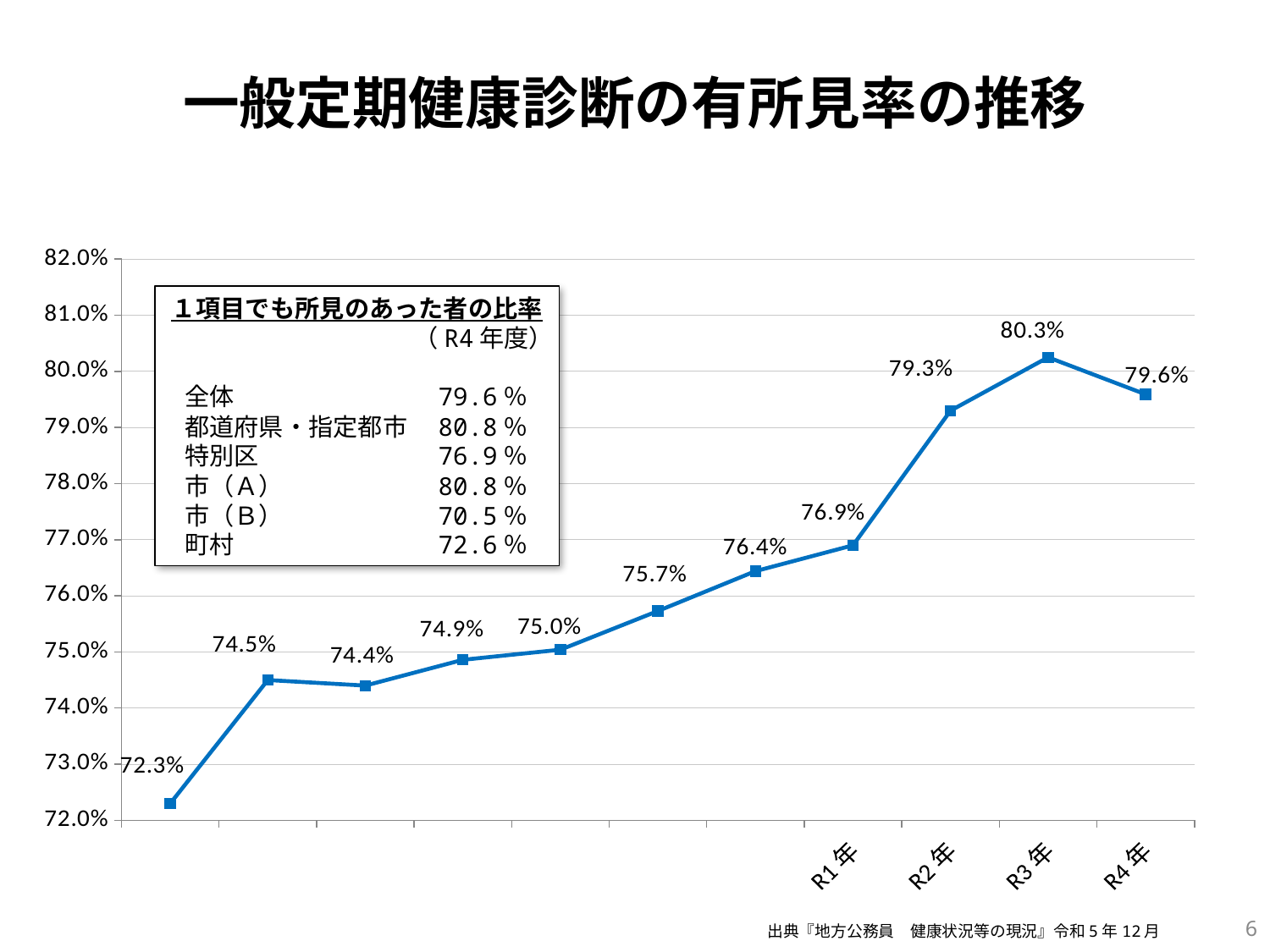
How many data points are plotted on the line? 11 What is the title of the slide? 一般定期健康診断の有所見率の推移 Which is larger, the value for R2年 or the value for R4年? R4年 What is the difference between the values for R3年 and R4年? 0.7 percentage points What is the lowest value shown on the chart? 72.3% What is the value plotted for R3年? 80.3% What is the value plotted for R4年? 79.6% What is the value plotted for R2年? 79.3% What type of chart is shown on the slide? line chart What is the value plotted for R1年? 76.9% Do the values generally rise or fall from the first point to R3年? rise Which year has the highest value on the chart? R3年